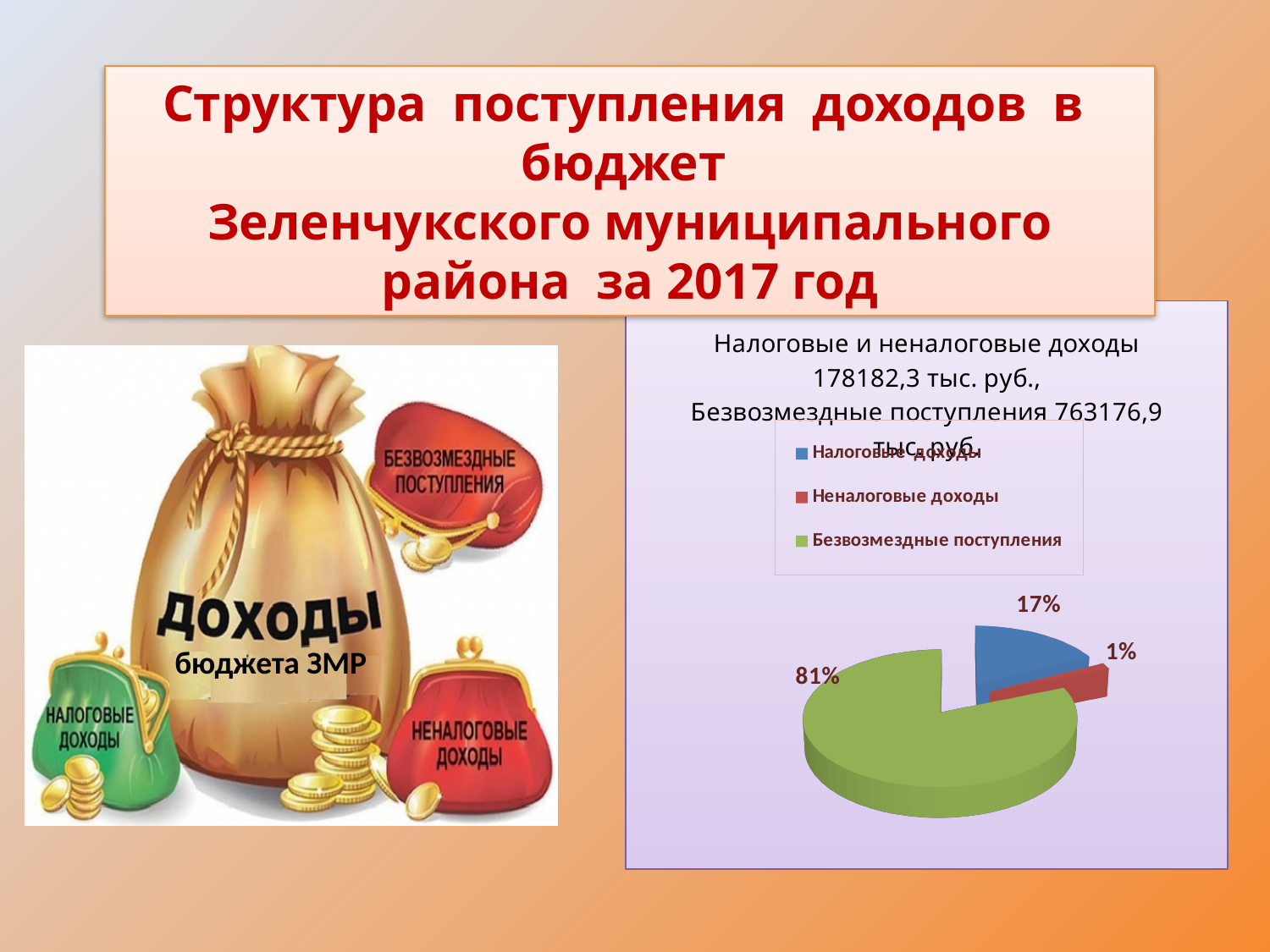
What share of the pie does Неналоговые доходы have? 1% What share of the pie does Налоговые доходы have? 17% How many slices does the pie chart have? 3 What kind of chart is shown on the slide? pie chart Which category has the smallest slice of the pie? Неналоговые доходы What is the difference in percentage points between the Безвозмездные поступления slice and the Налоговые доходы slice? 64 How many entries does the legend list? 3 Which category has the largest slice of the pie? Безвозмездные поступления Which slice is larger, Налоговые доходы or Неналоговые доходы? Налоговые доходы What share of the pie does Безвозмездные поступления have? 81% According to the chart title, what is the amount of Безвозмездные поступления in тыс. руб.? 763176,9 тыс. руб. What colour is the Безвозмездные поступления slice in the pie chart? green